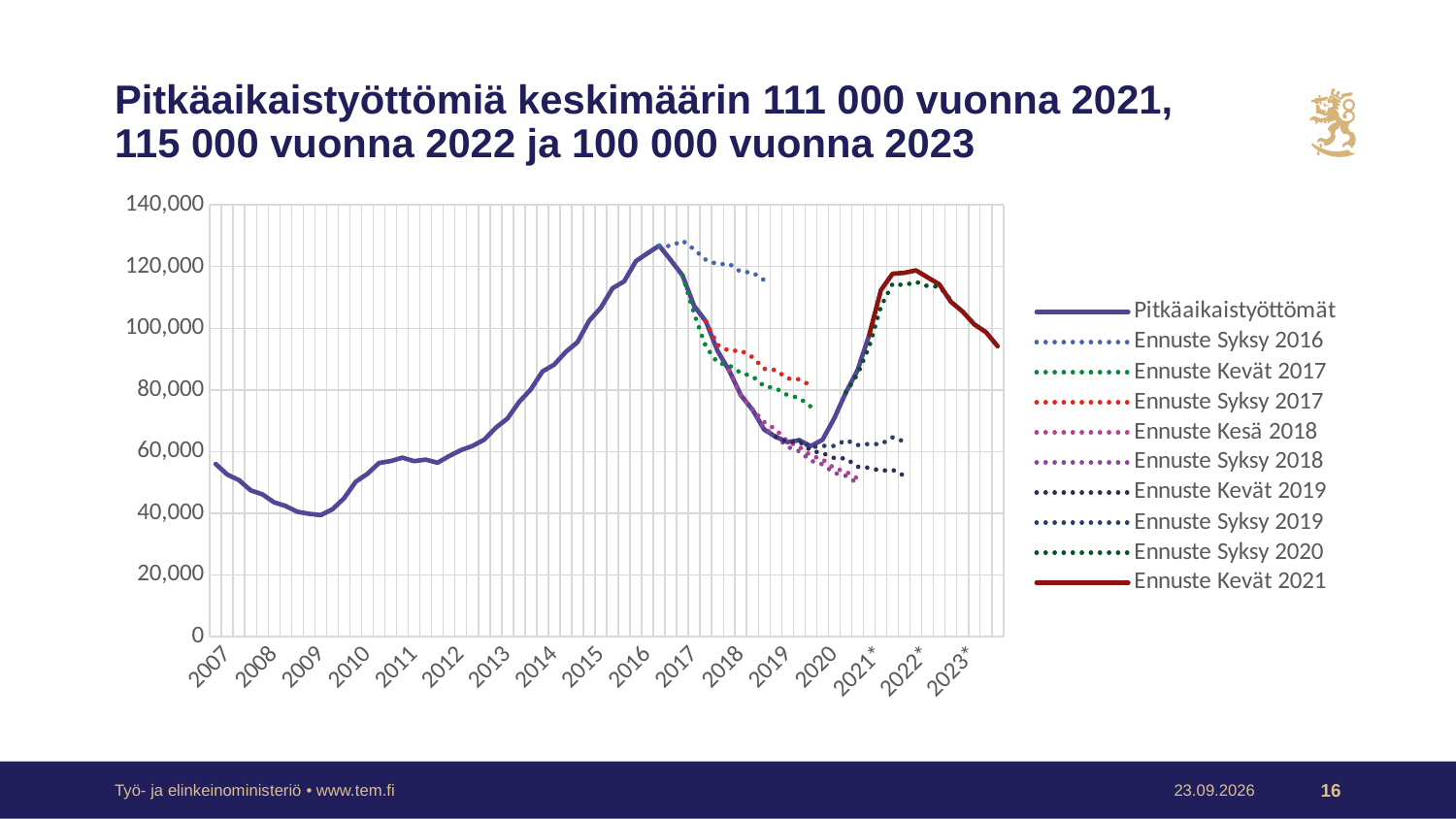
Does the Pitkäaikaistyöttömät line rise or fall between 2009 and 2016? rise Is the highest value of the Ennuste Kevät 2021 line greater or less than 100,000? greater Does the Pitkäaikaistyöttömät line rise or fall between 2016 and 2019? fall In which year does the Pitkäaikaistyöttömät line reach its highest value? 2016 Is the value of the Pitkäaikaistyöttömät line at the start of 2007 greater or less than 60,000? less How many series does the legend list? 10 How many years are labelled on the x axis? 17 Which series is drawn as a solid dark red line? Ennuste Kevät 2021 Is the final value of the Ennuste Syksy 2018 line greater or less than 60,000? less What kind of chart is shown on the slide? line chart What is the first series listed in the legend? Pitkäaikaistyöttömät